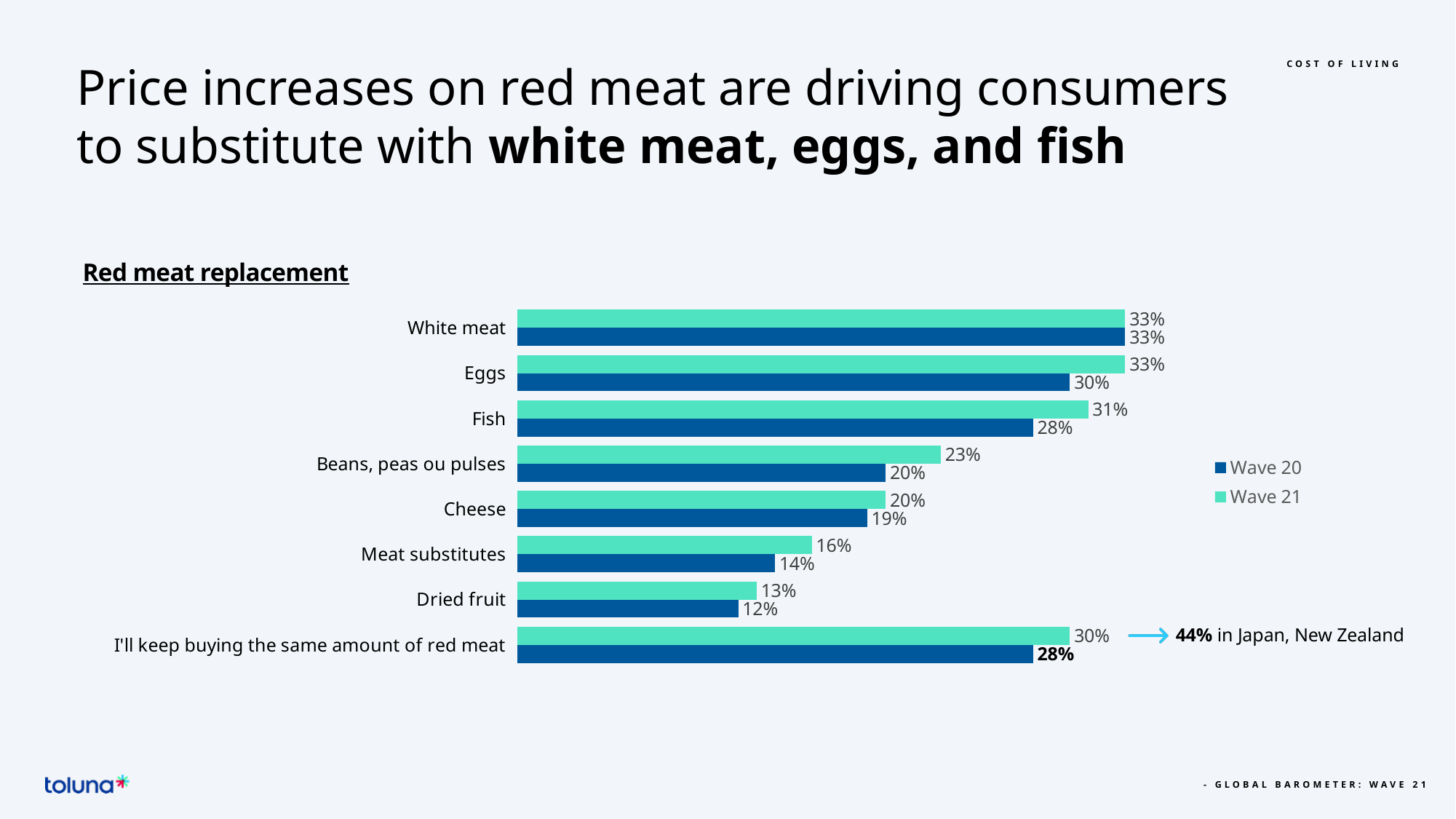
What is the Wave 20 value for Eggs? 30% What is the title of the chart? Red meat replacement What is the Wave 20 value for Meat substitutes? 14% How many categories are shown in the chart? 8 How many series does the legend list? 2 Which is larger for Beans, peas ou pulses: the Wave 20 value or the Wave 21 value? Wave 21 What is the Wave 21 value for Fish? 31% What is the difference between the Wave 21 and Wave 20 values for Eggs? 3% Which category has the lowest Wave 20 value? Dried fruit What kind of chart is shown on the slide? Bar chart What is the difference between the Wave 21 and Wave 20 values for Fish? 3% What is the Wave 21 value for 'I'll keep buying the same amount of red meat'? 30%